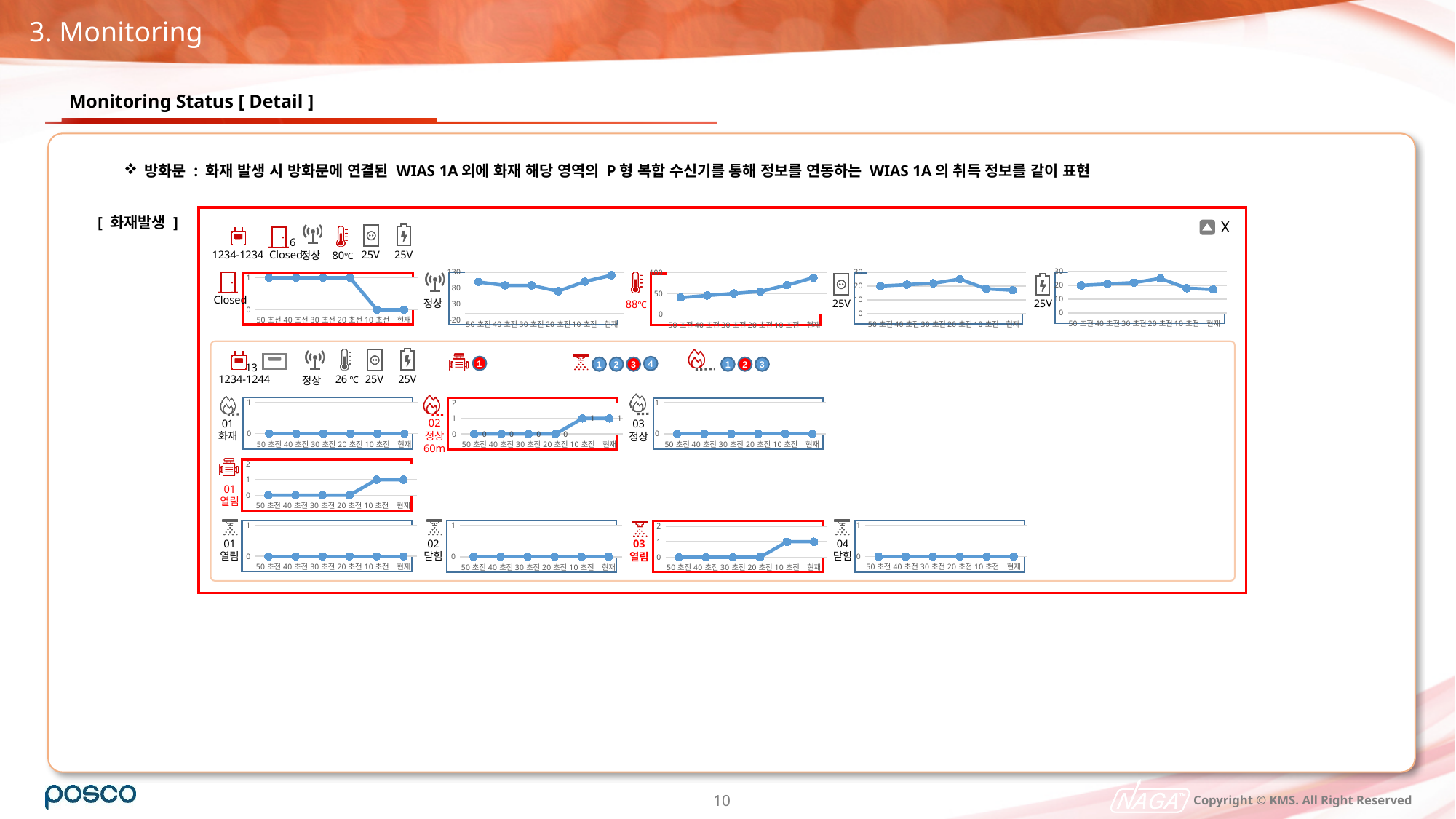
In the chart labelled 02 정상 60m, what is the value at 현재? 1 In the chart labelled 88℃ in the top row, is the value at 현재 greater or less than 50? greater In the chart labelled 정상 in the top row (second chart from the left), is the value at 현재 greater or less than 80? greater In the chart labelled 02 정상 60m, what is the value at 30 초전? 0 In the chart labelled Closed in the top row, what is the value at 현재? 0 In the sprinkler chart labelled 03 열림 in the bottom row, do the values rise or fall from 50 초전 to 현재? rise How many time points does the chart labelled Closed in the top row show along the x axis? 6 In the chart labelled Closed in the top row, what is the value at 50 초전? 1 What is the x-axis label of the last point in each of the charts? 현재 In the chart labelled 88℃ in the top row, do the values rise or fall from 50 초전 to 현재? rise What kind of chart is the chart labelled 88℃ in the top row? line chart In the chart labelled 88℃ in the top row, is the value at 50 초전 greater or less than 50? less